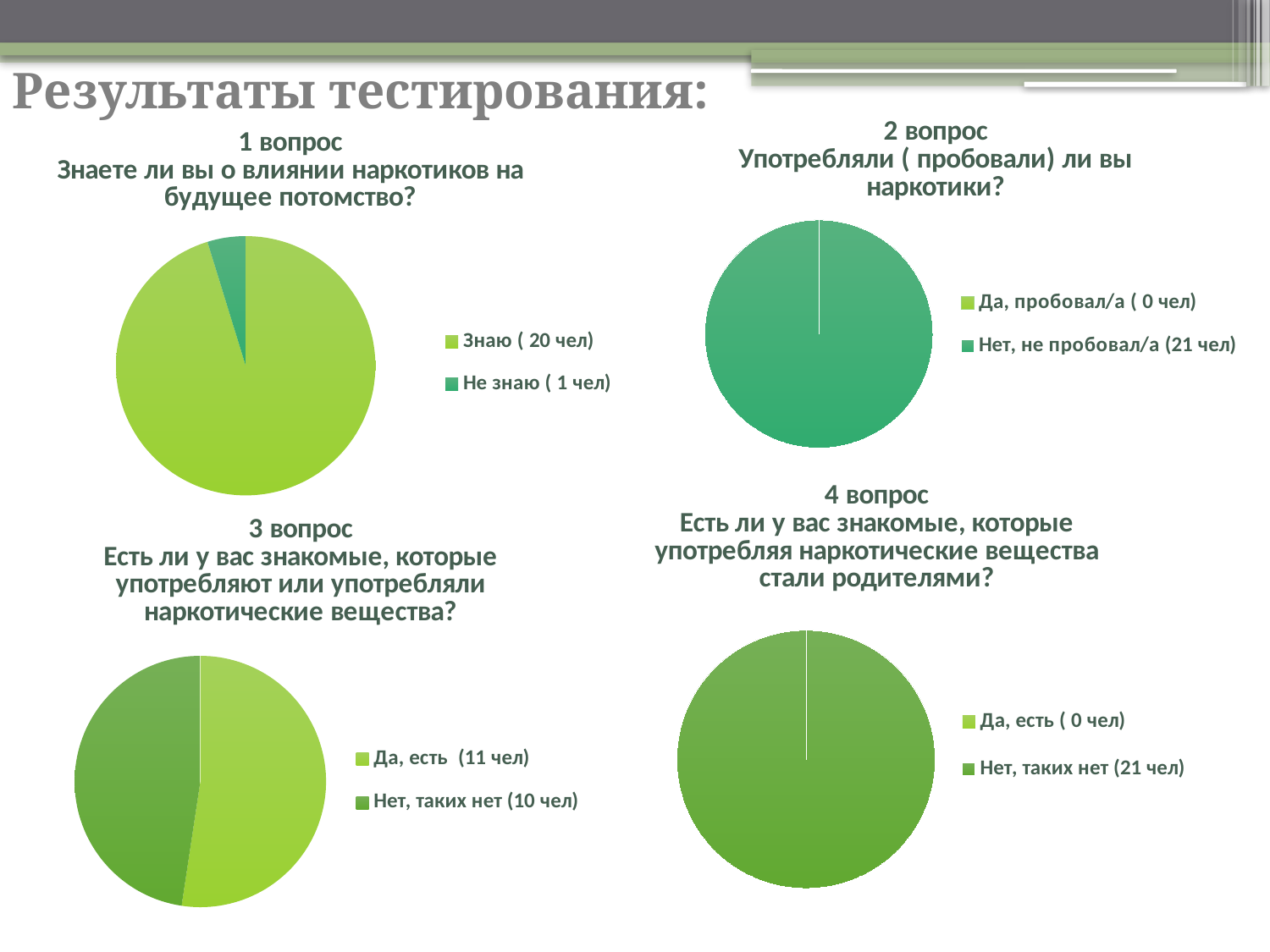
What kind of chart is used for '1 вопрос' (Знаете ли вы о влиянии наркотиков на будущее потомство?)? Pie chart In the '1 вопрос' chart, how many people answered 'Не знаю'? 1 чел In the '2 вопрос' chart, how many people answered 'Да, пробовал/а'? 0 чел In the '2 вопрос' chart (Употребляли ли вы наркотики?), how many people answered 'Нет, не пробовал/а'? 21 чел In the '1 вопрос' chart, how many people answered 'Знаю'? 20 чел In the '3 вопрос' chart, what is the difference between the 'Да, есть' and 'Нет, таких нет' counts? 1 чел In the '3 вопрос' chart, how many people answered 'Нет, таких нет'? 10 чел In the '3 вопрос' chart, how many people answered 'Да, есть'? 11 чел In the '4 вопрос' chart, how many people answered 'Нет, таких нет'? 21 чел How many pie charts are shown on the slide? 4 How many legend entries does the '2 вопрос' chart list? 2 In the '1 вопрос' chart, which answer has the larger slice? Знаю